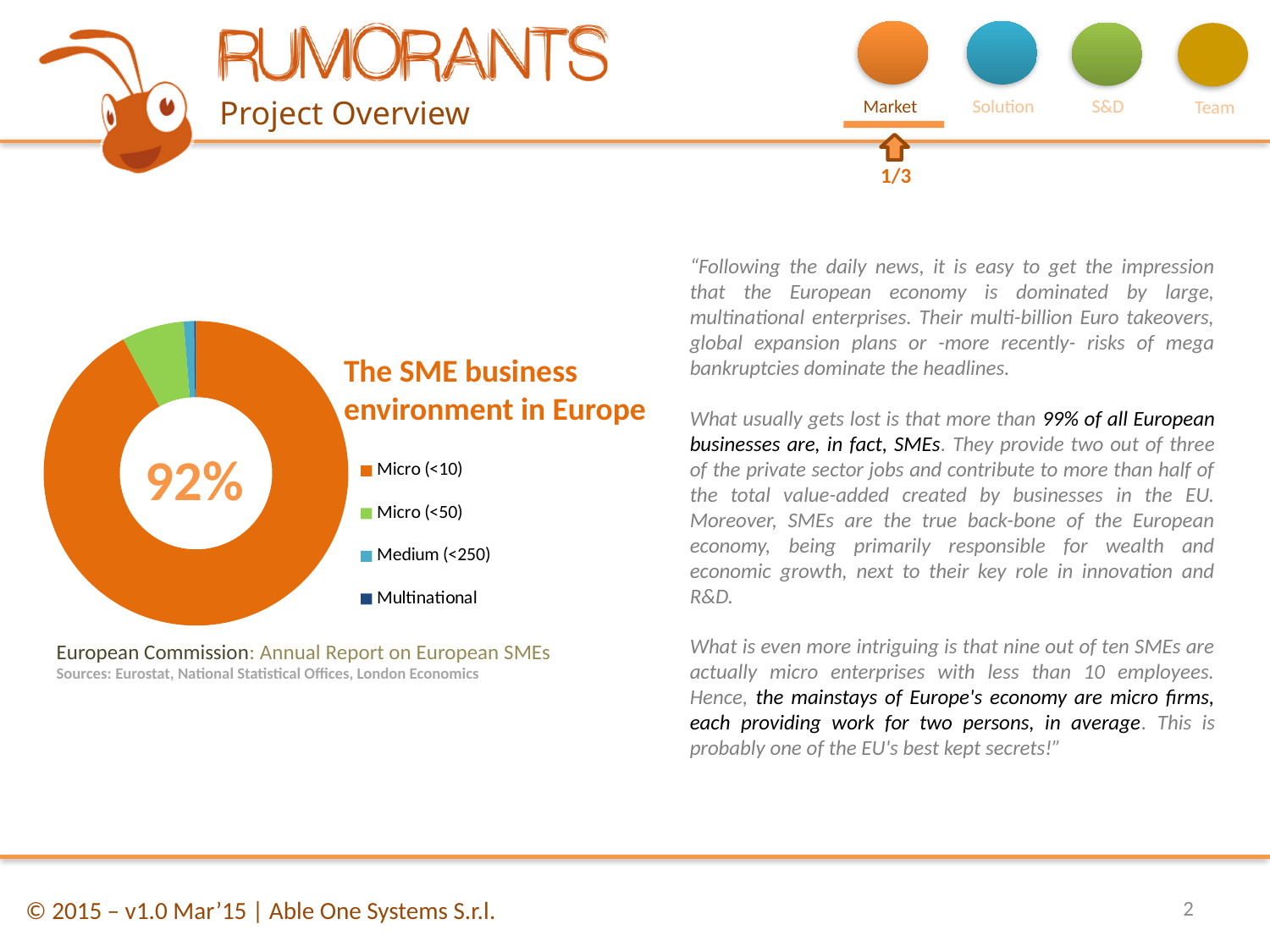
Which category is listed last in the chart's legend? Multinational What percentage value is printed in the centre of the doughnut chart? 92% Which category takes up the largest share of the doughnut chart? Micro (<10) Which is larger in the chart, the share for Micro (<10) or the share for Multinational? Micro (<10) How many categories does the chart's legend list? 4 What is the title of the chart on the slide? The SME business environment in Europe Which is larger in the chart, the share for Micro (<50) or the share for Medium (<250)? Micro (<50) Which is larger in the chart, the share for Micro (<10) or the share for Micro (<50)? Micro (<10) What colour represents the Micro (<10) category in the chart? Orange What kind of chart is shown on the slide? Doughnut (pie) chart